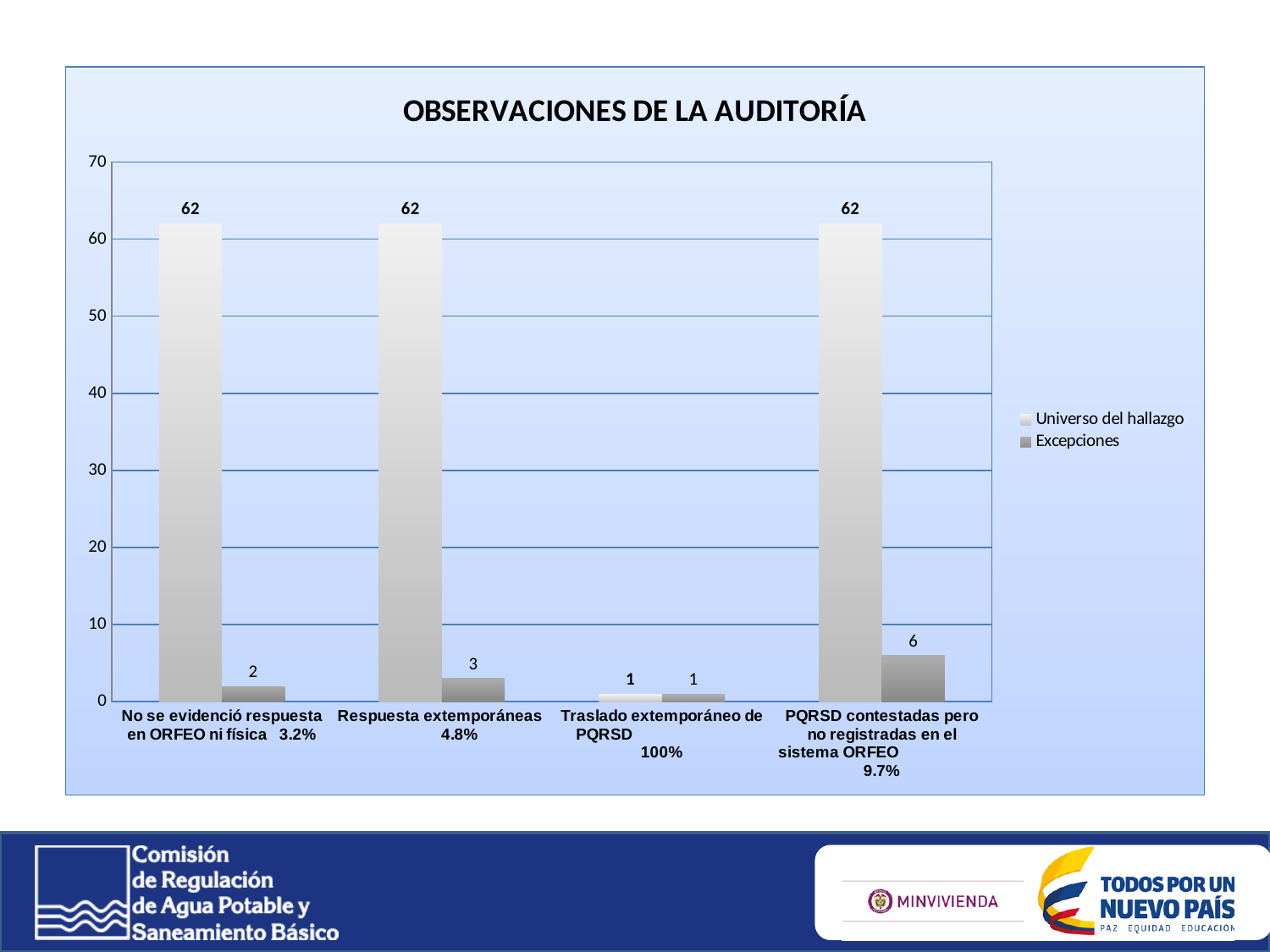
What type of chart is shown on the slide? Bar chart What is the value of Excepciones for 'No se evidenció respuesta en ORFEO ni física'? 2 Which is larger: Excepciones for 'Respuesta extemporáneas' or Excepciones for 'PQRSD contestadas pero no registradas en el sistema ORFEO'? PQRSD contestadas pero no registradas en el sistema ORFEO Which category has the lowest Universo del hallazgo value? Traslado extemporáneo de PQRSD What is the value of Universo del hallazgo for 'Traslado extemporáneo de PQRSD'? 1 How many series does the legend list? 2 Which category has the highest Excepciones value? PQRSD contestadas pero no registradas en el sistema ORFEO How many categories are shown on the x axis? 4 What is the difference between Universo del hallazgo and Excepciones for 'Respuesta extemporáneas'? 59 What is the value of Universo del hallazgo for 'Respuesta extemporáneas'? 62 What is the title of the chart? OBSERVACIONES DE LA AUDITORÍA What is the value of Excepciones for 'PQRSD contestadas pero no registradas en el sistema ORFEO'? 6